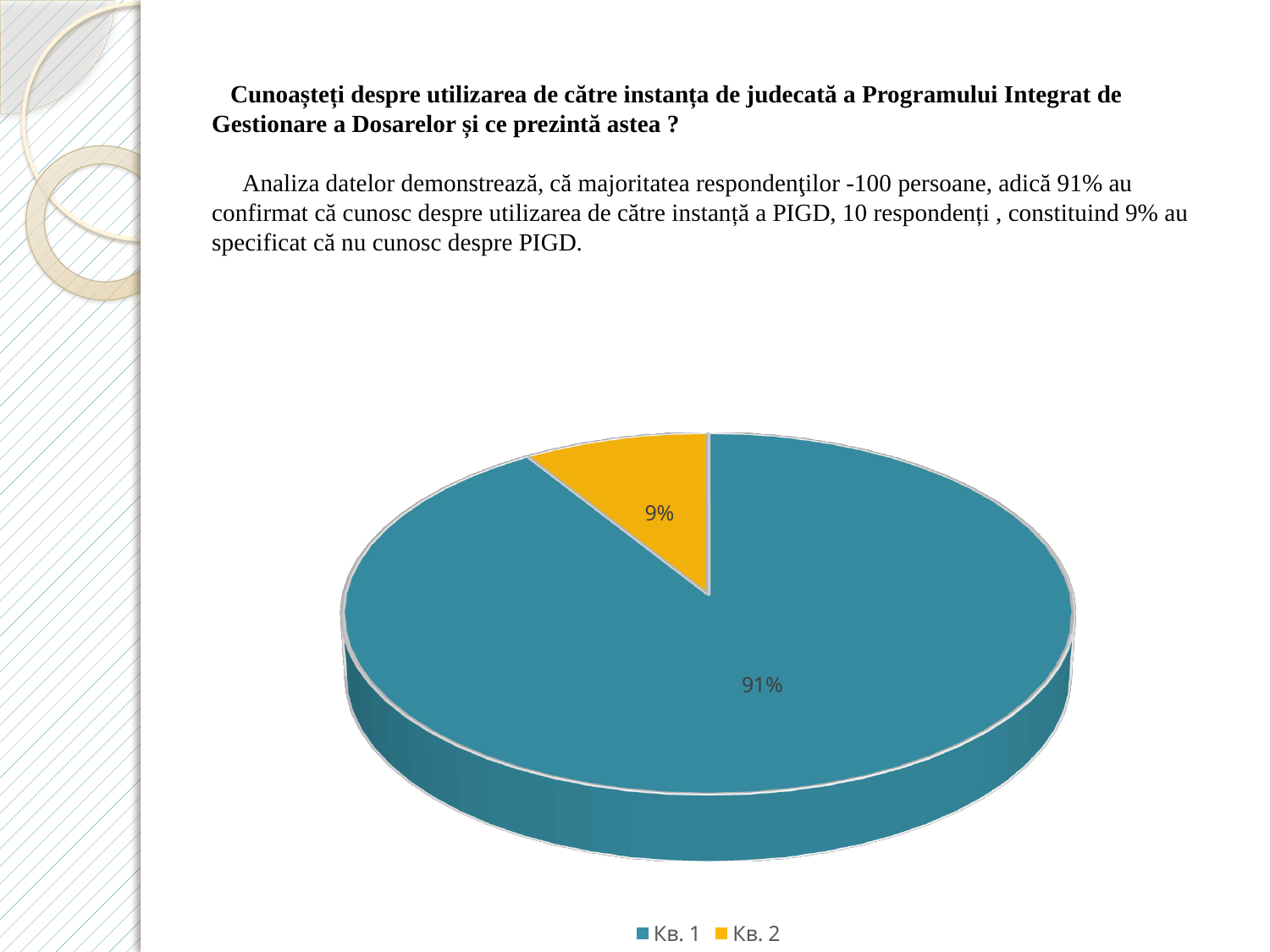
How many slices does the pie chart have? 2 Which slice of the pie is the largest? Кв. 1 What kind of chart is shown on the slide? pie chart What is the value labelled on the yellow slice of the pie? 9% What share of the pie does Кв. 2 represent? 9% What is the difference in percentage points between the Кв. 1 slice and the Кв. 2 slice? 82 Which slice of the pie is the smallest? Кв. 2 What colour is the slice for Кв. 2? yellow What share of the pie does Кв. 1 represent? 91% What is the value labelled on the teal slice of the pie? 91% Which is larger, the slice for Кв. 1 or the slice for Кв. 2? Кв. 1 How many entries does the legend list? 2